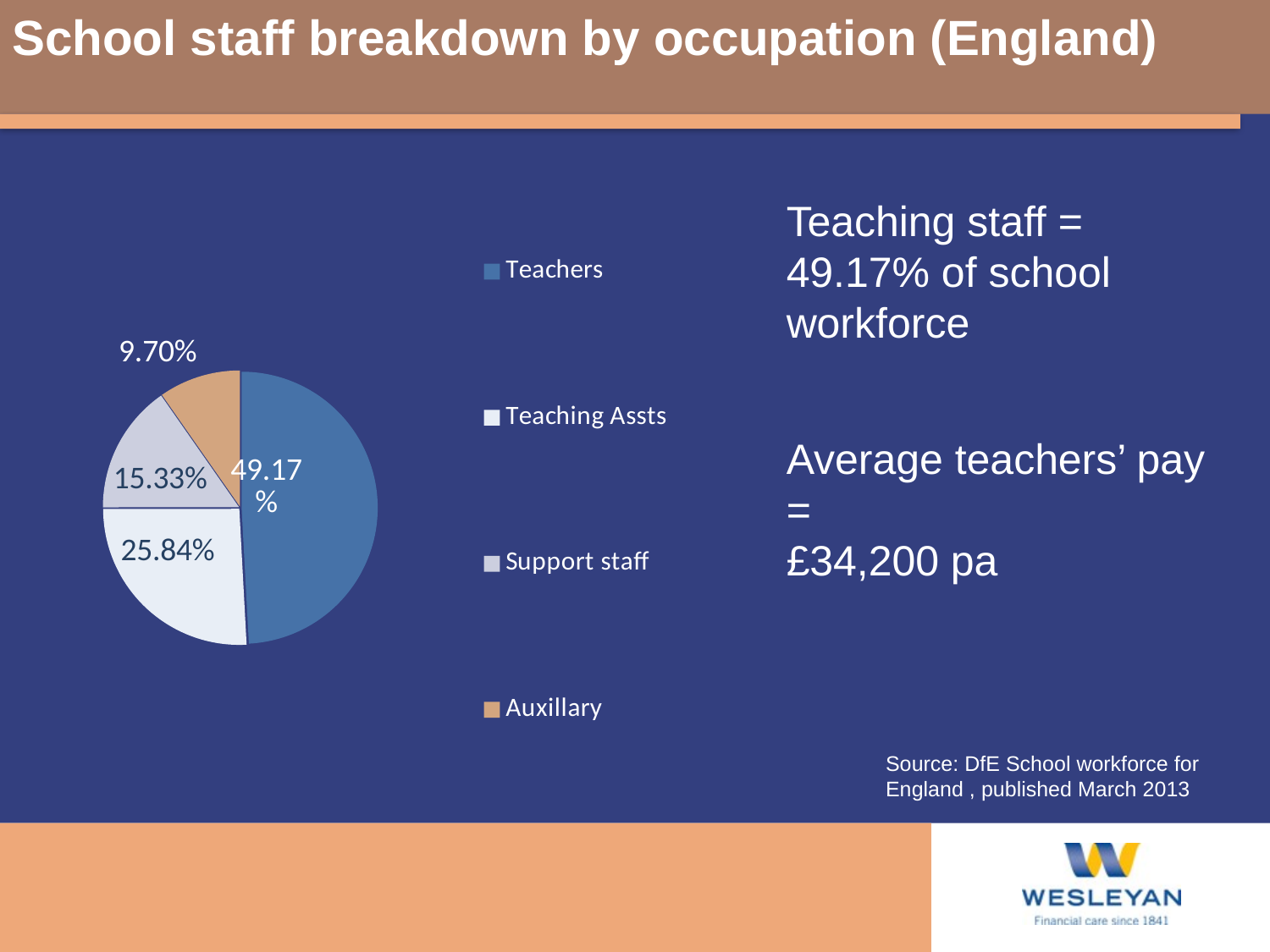
Which is larger, the share for Teaching Assts or the share for Support staff? Teaching Assts What percentage is shown for Teaching Assts? 25.84% What is the difference in percentage points between the Teachers share and the Teaching Assts share? 23.33 What percentage is shown for Auxillary? 9.70% Which occupation has the smallest share of the pie? Auxillary What percentage of the school workforce is shown for Teachers? 49.17% What kind of chart is shown on the slide? pie chart How many entries does the legend list? 4 Which occupation has the largest share of the pie? Teachers How many slices does the pie chart have? 4 What is the title of the slide containing the pie chart? School staff breakdown by occupation (England) What percentage is shown for Support staff? 15.33%